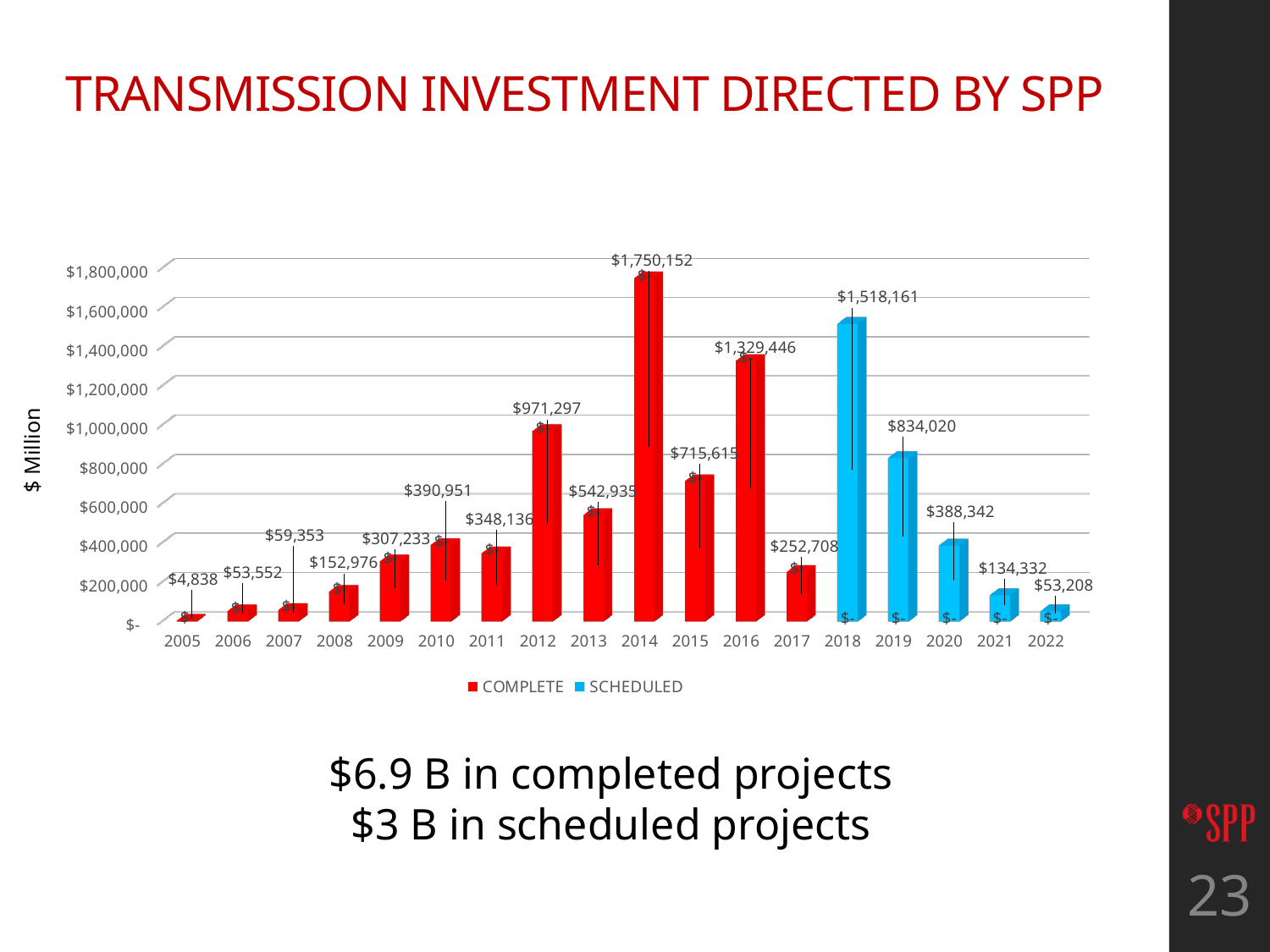
Which year has the highest value in the chart? 2014 Is the value for 2016 greater or less than $1,200,000? greater What is the scheduled investment value shown for 2018? $1,518,161 Which year has the lowest value in the chart? 2005 Which is larger, the value for 2012 or the value for 2019? 2012 What kind of chart is shown on the slide? bar chart What is the value shown for 2005? $4,838 What is the difference between the values for 2014 and 2018? $231,991 How many years are shown on the x axis of the chart? 18 How many series does the legend list? 2 What is the value for 2014 in the chart? $1,750,152 Do the scheduled values rise or fall from 2018 to 2022? fall